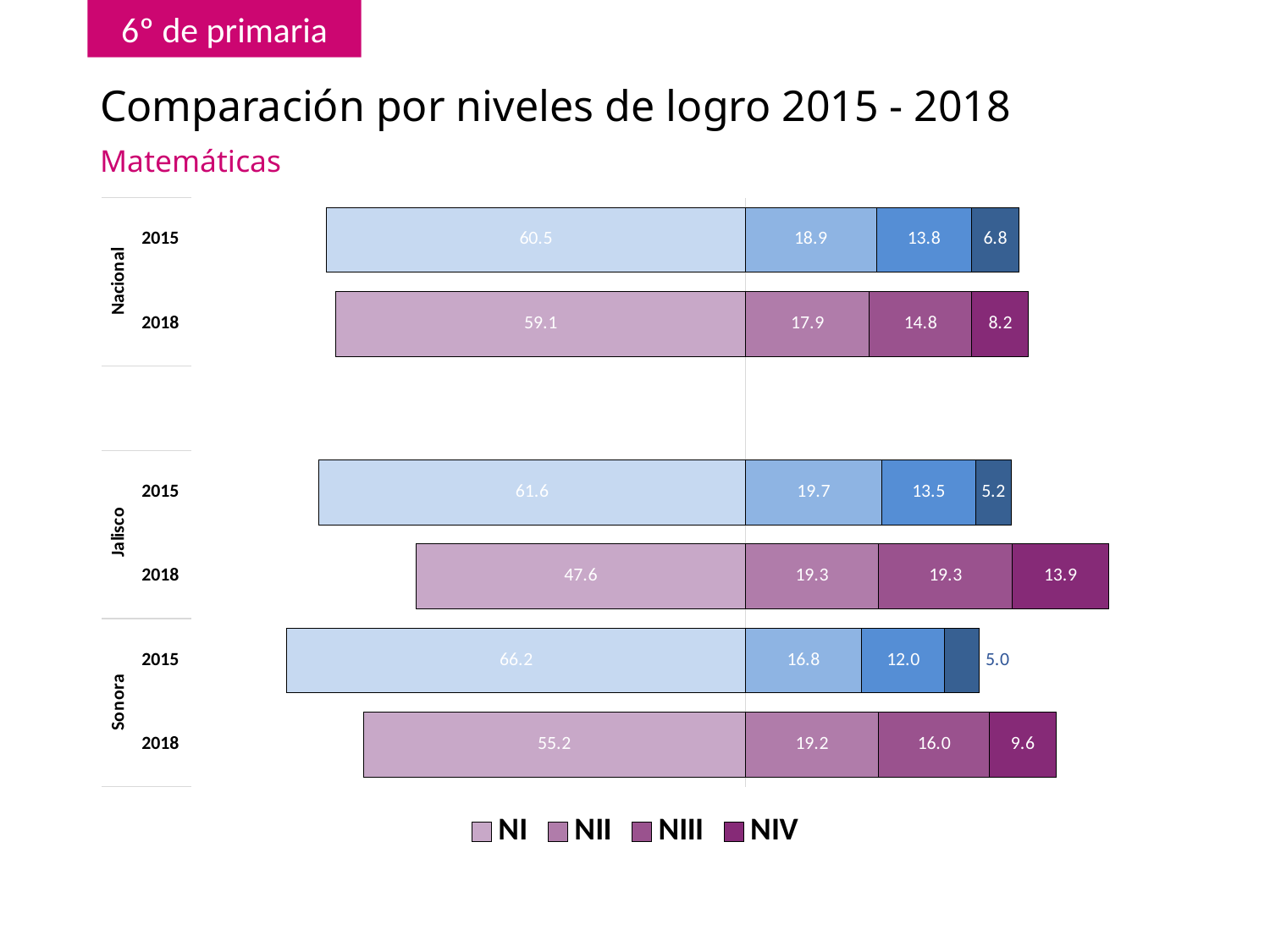
How many series does the legend list? 4 What is the NII value for Sonora in 2015? 16.8 Which bar has the highest NI value? Sonora 2015 What is the total of the Nacional 2015 bar? 100.0 What is the difference between the NIV value for Nacional in 2018 and in 2015? 1.4 What kind of chart is shown on the slide? Stacked bar chart How many bars are shown in the chart? 6 By how much did the NI value for Jalisco decrease from 2015 to 2018? 14.0 What is the NI value for Nacional in 2015? 60.5 Which is larger, the NIII value for Sonora 2018 or for Nacional 2018? Sonora 2018 Which bar has the lowest NIV value? Sonora 2015 What is the NIV value for Jalisco in 2018? 13.9